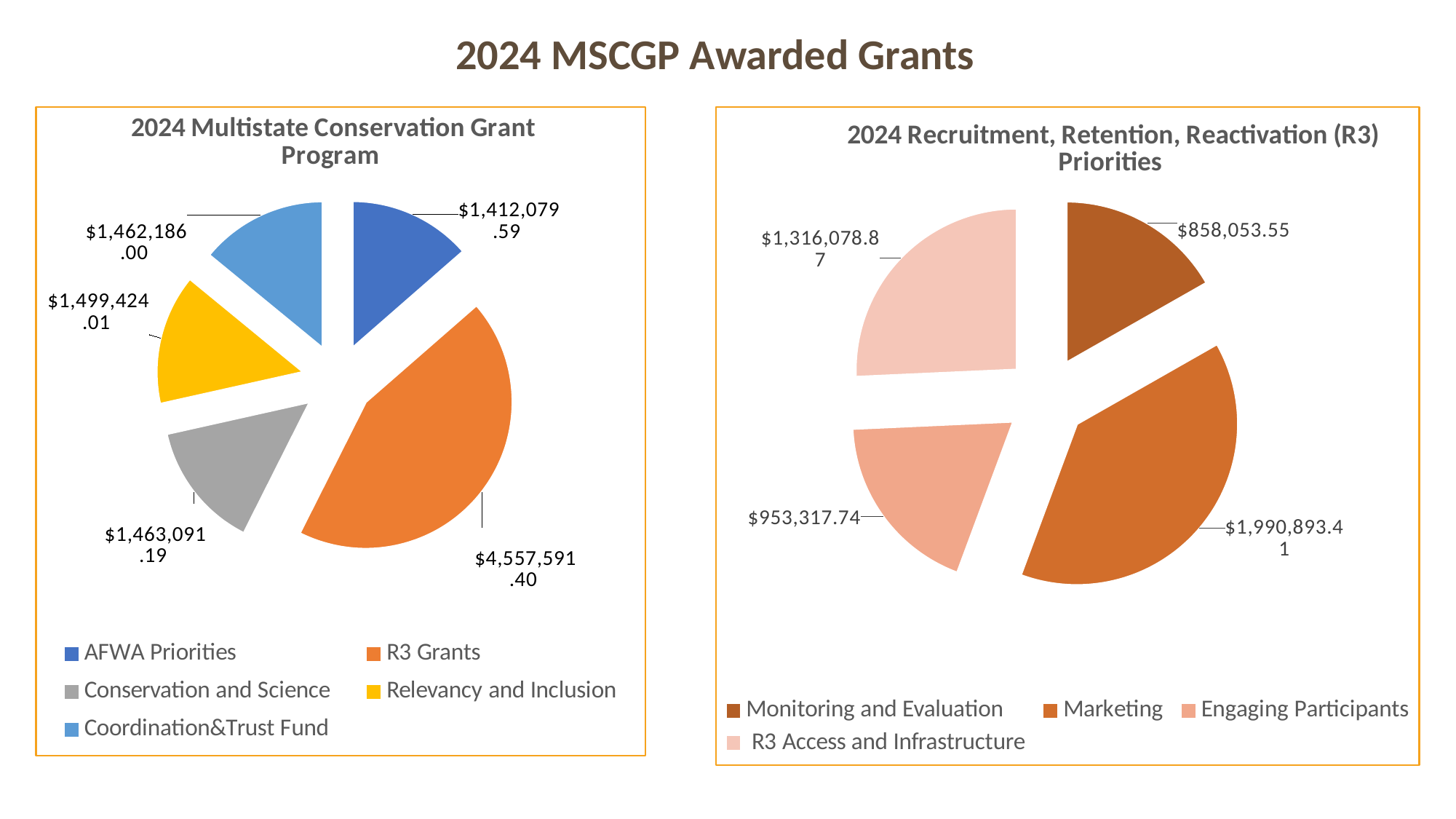
How many categories does the legend of the 2024 Multistate Conservation Grant Program chart list? 5 In the 2024 Recruitment, Retention, Reactivation (R3) Priorities chart, what is the difference between Marketing and Monitoring and Evaluation? $1,132,839.86 In the 2024 Recruitment, Retention, Reactivation (R3) Priorities chart, which is larger: R3 Access and Infrastructure or Engaging Participants? R3 Access and Infrastructure In the 2024 Recruitment, Retention, Reactivation (R3) Priorities chart, what is the value for Marketing? $1,990,893.41 In the 2024 Recruitment, Retention, Reactivation (R3) Priorities chart, what is the value for Engaging Participants? $953,317.74 In the 2024 Multistate Conservation Grant Program chart, which category has the largest slice? R3 Grants What kind of chart is the 2024 Recruitment, Retention, Reactivation (R3) Priorities chart? Pie chart In the 2024 Multistate Conservation Grant Program chart, what is the value for Relevancy and Inclusion? $1,499,424.01 In the 2024 Recruitment, Retention, Reactivation (R3) Priorities chart, which category has the smallest slice? Monitoring and Evaluation In the 2024 Multistate Conservation Grant Program chart, what is the value for R3 Grants? $4,557,591.40 In the 2024 Multistate Conservation Grant Program chart, what is the value for Coordination&Trust Fund? $1,462,186.00 In the 2024 Multistate Conservation Grant Program chart, what is the difference between R3 Grants and AFWA Priorities? $3,145,511.81